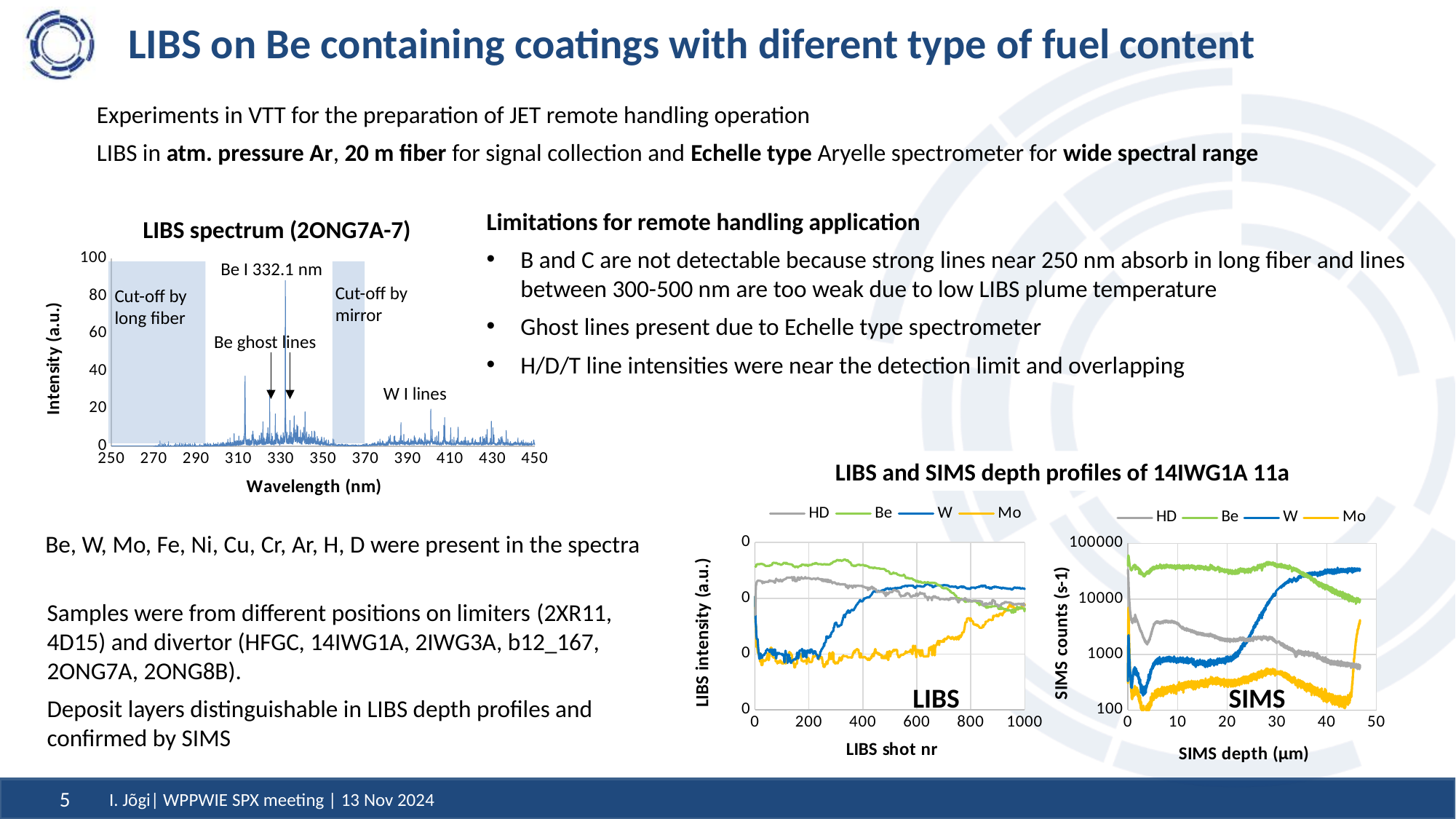
In the LIBS depth profile chart (LIBS shot nr on the x axis), does the W intensity rise or fall between shot 200 and shot 400? rise In the LIBS depth profile chart (LIBS shot nr on the x axis), how many series does the legend list? 4 In the LIBS spectrum (2ONG7A-7), what is the label of the x axis? Wavelength (nm) In the LIBS spectrum (2ONG7A-7), which labelled line gives the tallest peak? Be I 332.1 nm In the LIBS depth profile chart (LIBS shot nr on the x axis), which series has the highest intensity at shot number 200? Be In the LIBS spectrum (2ONG7A-7), is the intensity of the Be I 332.1 nm peak greater or less than 80? greater In the LIBS depth profile chart (LIBS shot nr on the x axis), does the Be intensity rise or fall between shot 400 and shot 1000? fall What kind of chart is the LIBS spectrum (2ONG7A-7)? line chart In the SIMS depth profile chart (SIMS depth on the x axis), which series has the lowest counts at a depth of 10 µm? Mo In the SIMS depth profile chart (SIMS depth on the x axis), which series has the highest counts at a depth of 10 µm? Be In the LIBS spectrum (2ONG7A-7), what is the highest wavelength shown on the x axis? 450 In the SIMS depth profile chart (SIMS depth on the x axis), are the W counts at a depth of 45 µm greater or less than 10000? greater